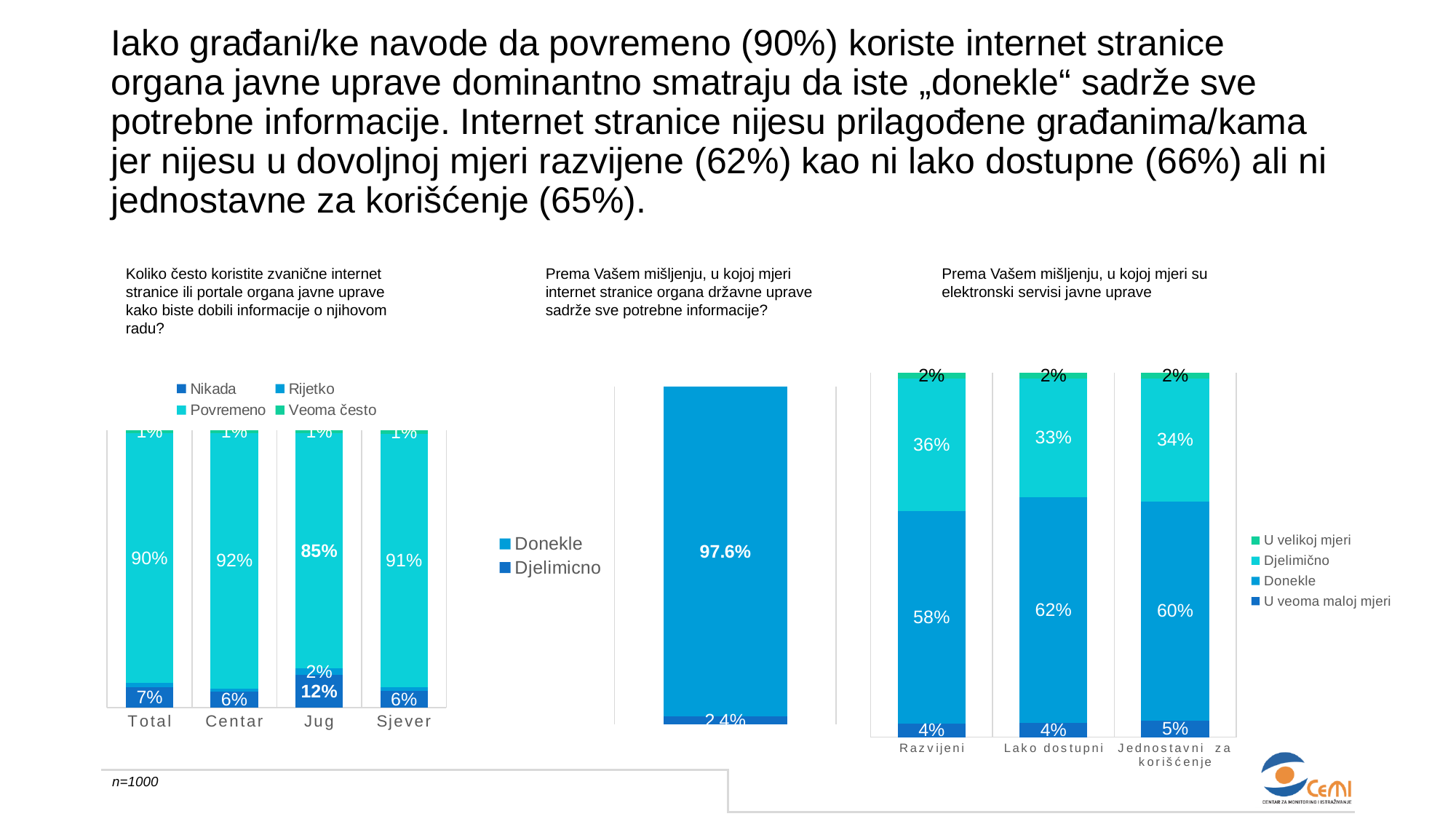
In the left chart (Koliko često koristite zvanične internet stranice...), what is the Povremeno value for Total? 90% In the right chart (Prema Vašem mišljenju, u kojoj mjeri su elektronski servisi javne uprave), which category has the highest Djelimično value? Razvijeni In the left chart (Koliko često koristite zvanične internet stranice...), how many categories are shown on the x axis? 4 In the right chart (Prema Vašem mišljenju, u kojoj mjeri su elektronski servisi javne uprave), what is the Donekle value for Lako dostupni? 62% In the left chart (Koliko često koristite zvanične internet stranice...), which category has the highest Povremeno value? Centar In the left chart (Koliko često koristite zvanične internet stranice...), which category has the lowest Povremeno value? Jug In the right chart (Prema Vašem mišljenju, u kojoj mjeri su elektronski servisi javne uprave), is the Donekle value for Razvijeni larger or smaller than the Donekle value for Jednostavni za korišćenje? smaller In the middle chart (Prema Vašem mišljenju, u kojoj mjeri internet stranice organa državne uprave sadrže sve potrebne informacije?), what is the value for Djelimicno? 2.4% In the left chart (Koliko često koristite zvanične internet stranice...), what is the difference between the Povremeno values for Centar and Jug? 7% In the left chart (Koliko često koristite zvanične internet stranice...), how many series does the legend list? 4 In the middle chart (Prema Vašem mišljenju, u kojoj mjeri internet stranice organa državne uprave sadrže sve potrebne informacije?), what is the value for Donekle? 97.6% What kind of chart is the right chart (Prema Vašem mišljenju, u kojoj mjeri su elektronski servisi javne uprave)? stacked bar chart